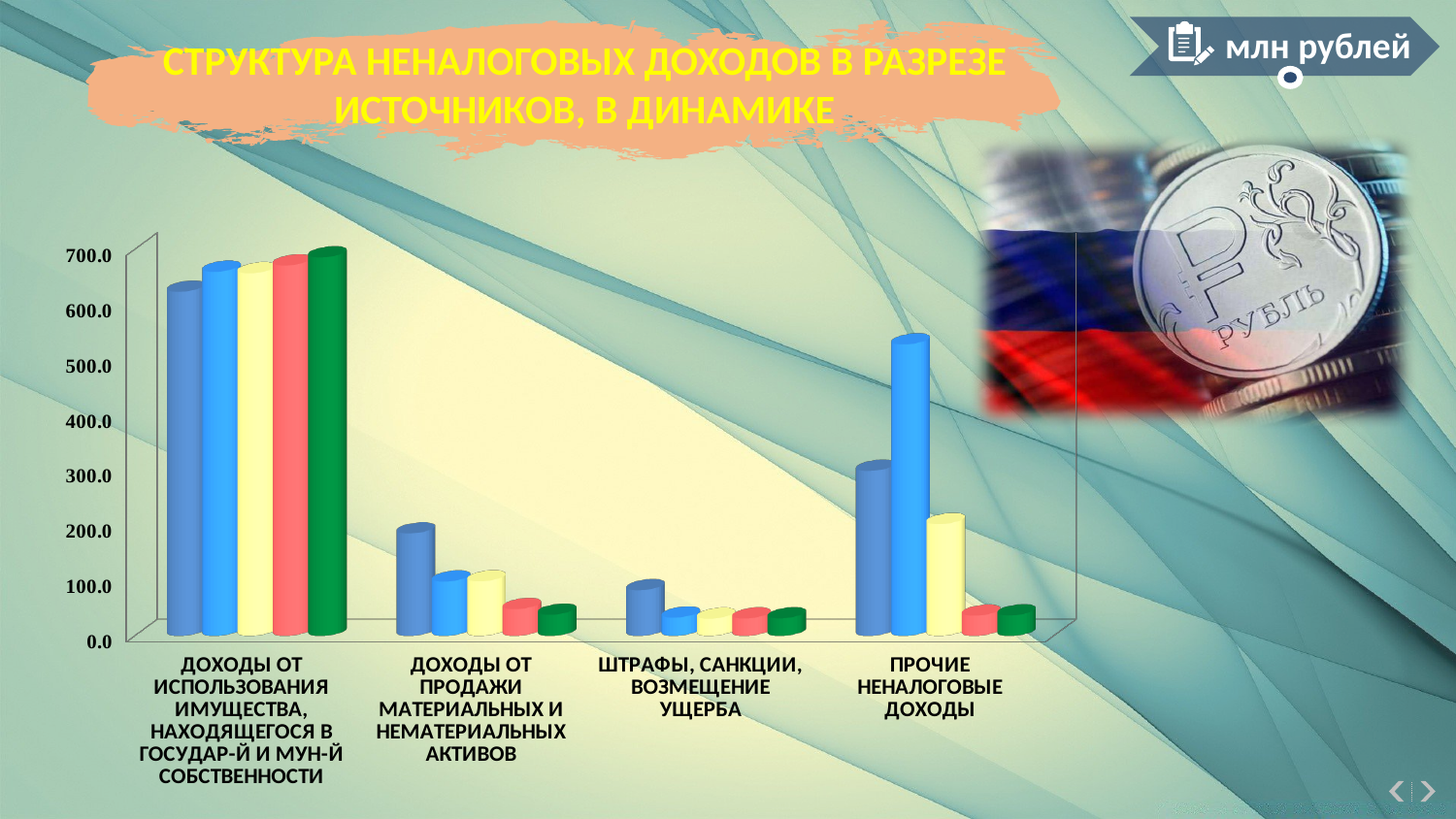
Is the value of the first (dark blue) bar for 'Доходы от использования имущества, находящегося в государ-й и мун-й собственности' greater or less than 600.0? greater In what units are the values on the chart expressed, according to the label in the top right corner? млн рублей Is the value of the first (dark blue) bar for 'Доходы от продажи материальных и нематериальных активов' greater or less than 100.0? greater What type of chart is shown on the slide? bar chart Is the value of the green bar for 'Штрафы, санкции, возмещение ущерба' greater or less than 100.0? less Which category has the lowest values on the chart? Штрафы, санкции, возмещение ущерба How many categories are shown on the x axis of the chart? 4 Which is larger: the dark blue bar for 'Прочие неналоговые доходы' or the dark blue bar for 'Доходы от продажи материальных и нематериальных активов'? Прочие неналоговые доходы Which category has the highest values on the chart? Доходы от использования имущества, находящегося в государ-й и мун-й собственности What is the title of the chart on the slide? СТРУКТУРА НЕНАЛОГОВЫХ ДОХОДОВ В РАЗРЕЗЕ ИСТОЧНИКОВ, В ДИНАМИКЕ How many bars are plotted for each category in the chart? 5